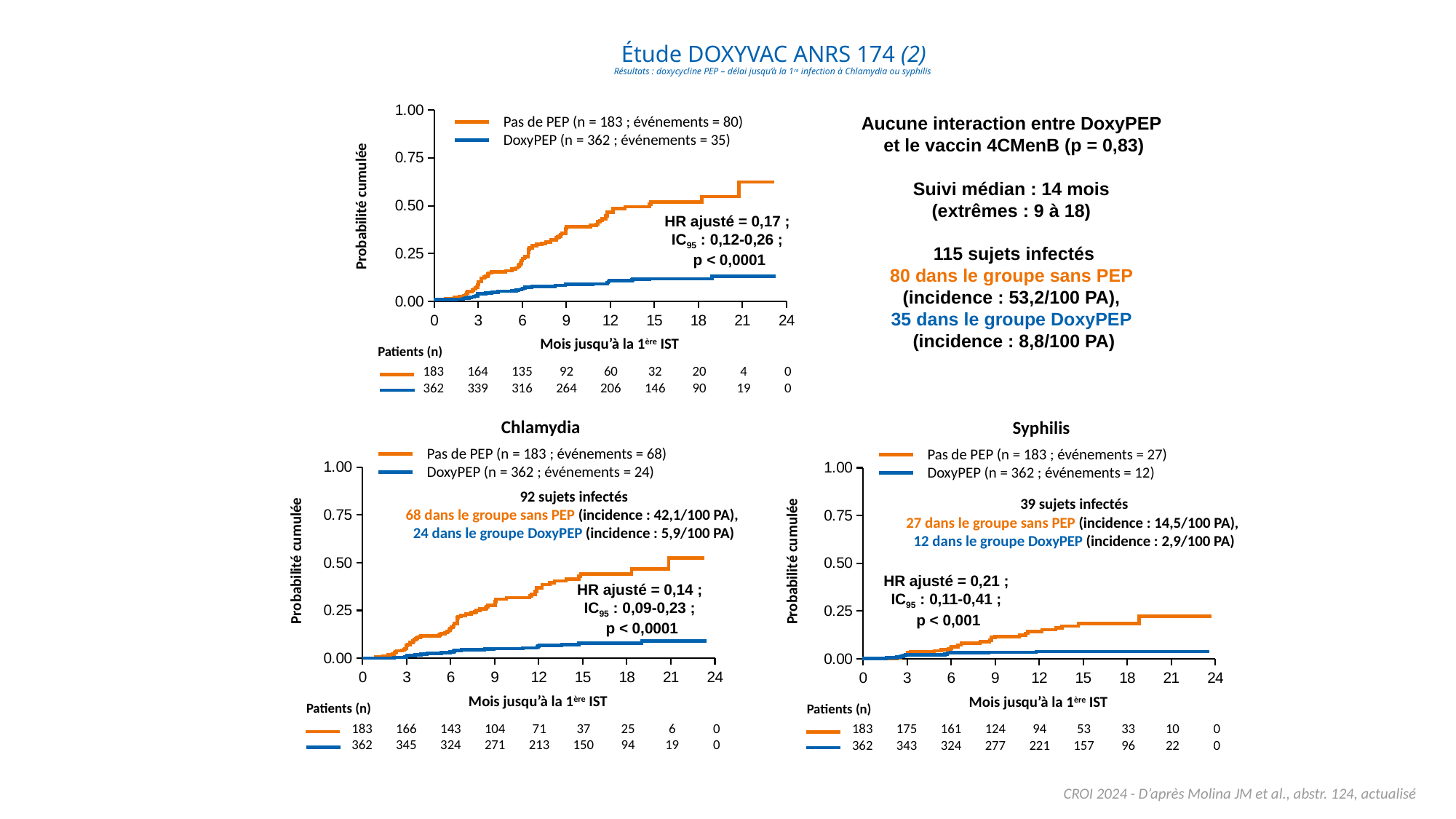
What kind of chart is the top chart on the slide? line chart In the Chlamydia chart, how many patients (n) are at risk in the DoxyPEP group at month 12? 213 In the top chart, how many events are reported in the legend for the Pas de PEP group? 80 In the Syphilis chart, is the cumulative probability for the DoxyPEP curve at month 21 greater or less than 0.25? less In the top chart, how many series does the legend list? 2 In the Syphilis chart, how many patients (n) are at risk in the Pas de PEP group at month 9? 124 In the Chlamydia chart, how many time points are listed in the Patients (n) table below the x axis? 9 In the Chlamydia chart, which curve is higher at month 18, Pas de PEP or DoxyPEP? Pas de PEP In the Chlamydia chart, what is the difference between the number of events in the Pas de PEP group and the DoxyPEP group as given in the legend? 44 In the top chart, is the cumulative probability for the Pas de PEP curve at month 21 greater or less than 0.50? greater In the top chart, does the Pas de PEP curve rise or fall as months increase? rise In the Syphilis chart, what is the adjusted hazard ratio (HR ajusté) shown? 0,21